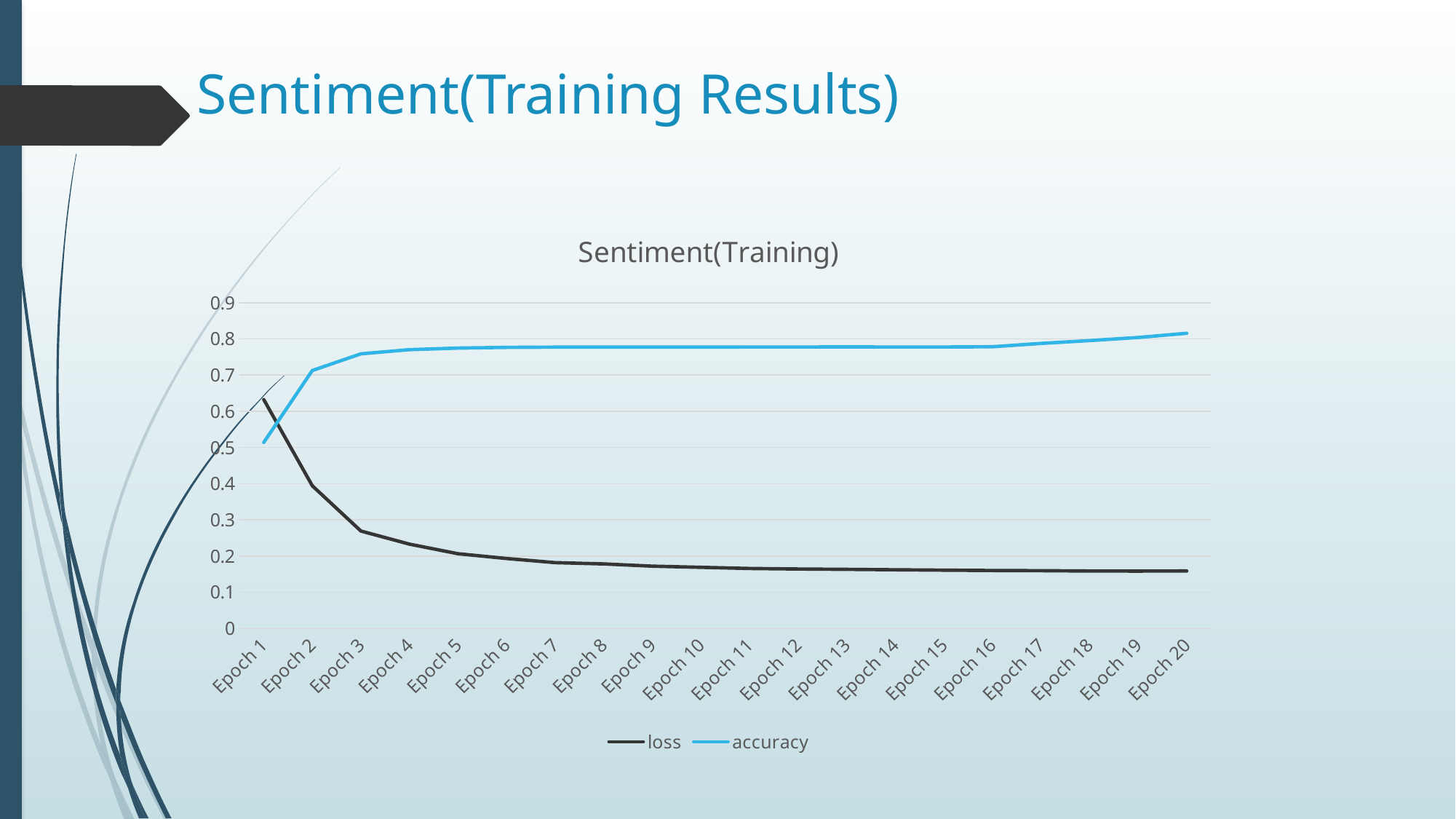
How many series does the legend list? 2 At which epoch is the loss highest? Epoch 1 Does the loss series rise or fall from Epoch 1 to Epoch 20? fall What kind of chart is shown on the slide? line chart Which series is drawn in light blue? accuracy What is the title of the chart? Sentiment(Training) At Epoch 1, which is larger, loss or accuracy? loss How many epochs are plotted along the x axis? 20 At which epoch is the accuracy lowest? Epoch 1 Is the loss value at Epoch 10 greater or less than 0.2? less Does the accuracy series rise or fall from Epoch 1 to Epoch 20? rise Is the accuracy value at Epoch 20 greater or less than 0.8? greater